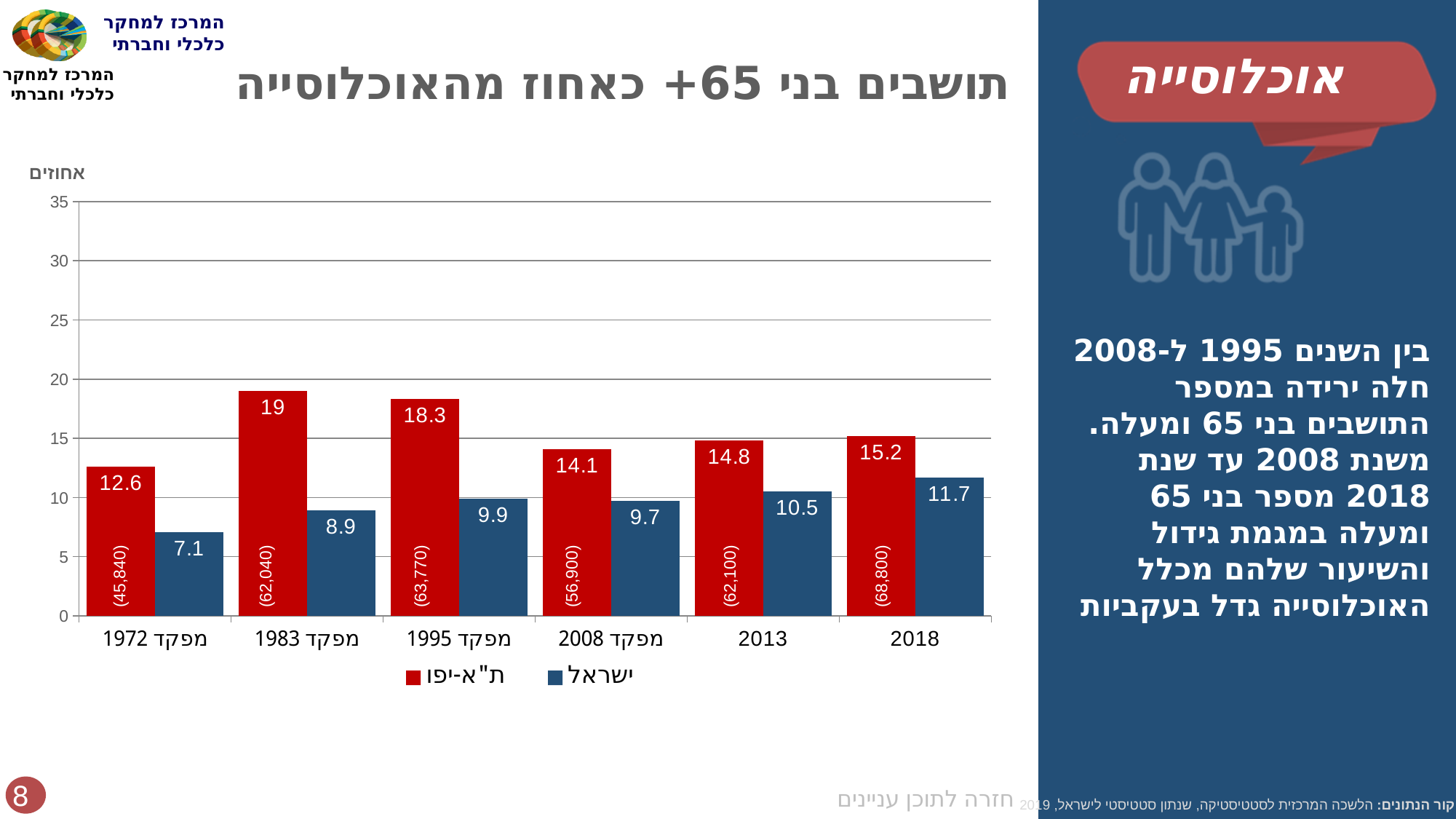
In which year is the ת"א-יפו value highest? מפקד 1983 What is the value for ת"א-יפו in מפקד 1983? 19 How many series does the legend list? 2 What is the value for ת"א-יפו in מפקד 2008? 14.1 How many years (categories) are shown on the x axis? 6 In which year is the ישראל value lowest? מפקד 1972 Which is larger in 2013: the ת"א-יפו value or the ישראל value? ת"א-יפו What number is printed in parentheses inside the ת"א-יפו bar for מפקד 1995? (63,770) What is the difference between the ת"א-יפו and ישראל values in מפקד 1972? 5.5 Does the ישראל series rise or fall from מפקד 1972 to 2018? rise What kind of chart is shown on the slide? bar chart What is the value for ישראל in 2018? 11.7